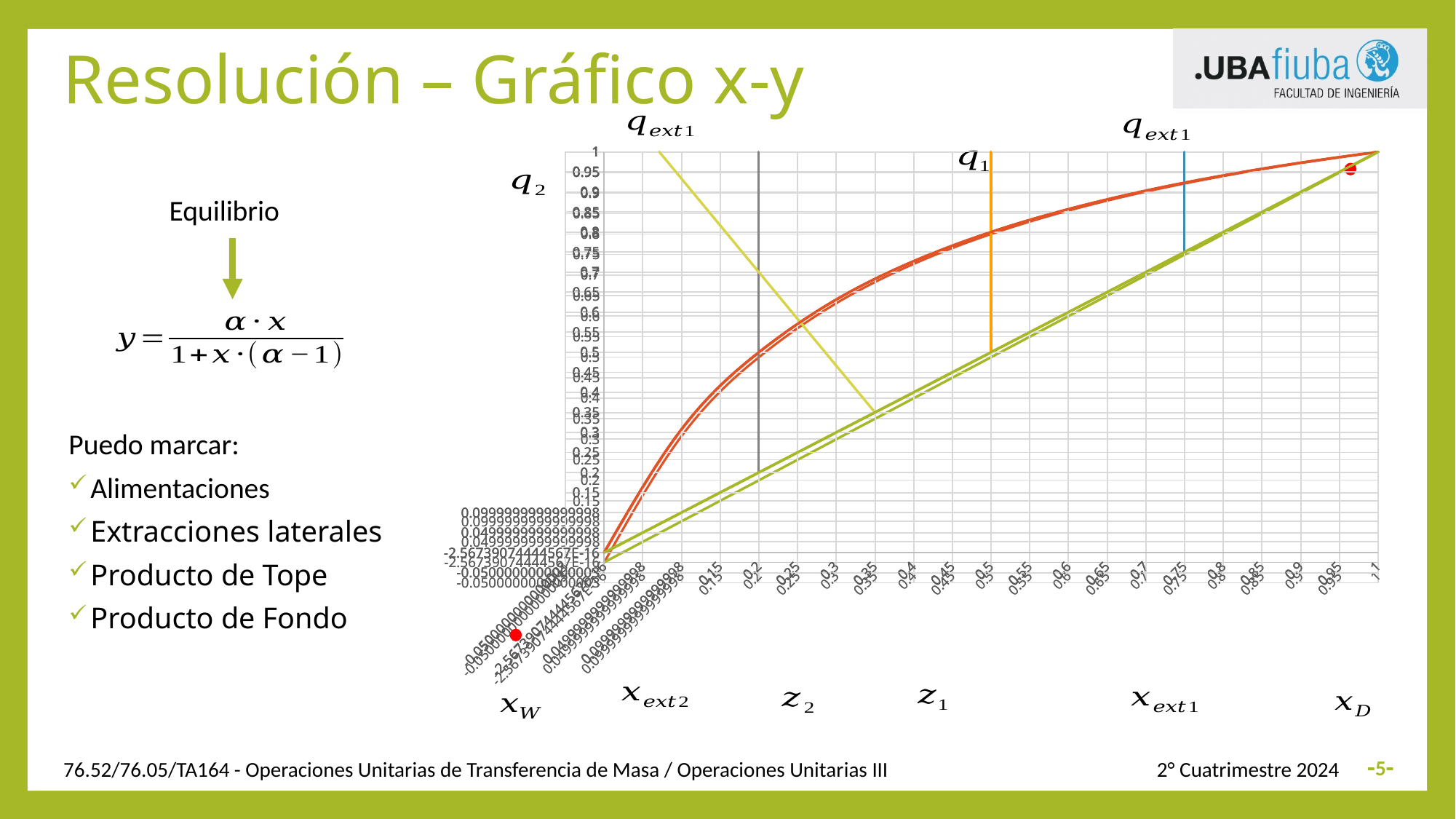
Which label is written at the top of the orange vertical line in the chart? q1 Is the value of the curved equilibrium line at x = 0.2 (where the grey vertical line meets it) greater or less than 0.4? greater What kind of chart is shown on the slide? line chart At x = 0.5, which is larger: the curved equilibrium line or the straight diagonal line? the curved equilibrium line Is the value of the curved equilibrium line at x = 0.75 (where the blue vertical line meets it) greater or less than 0.8? greater Is the value of the straight diagonal line at x = 0.5 greater or less than 0.7? less What is the title of the slide containing the chart? Resolución – Gráfico x-y Does the curved equilibrium line rise or fall as x increases along the x axis? rises What is the highest tick value shown on the y axis? 1